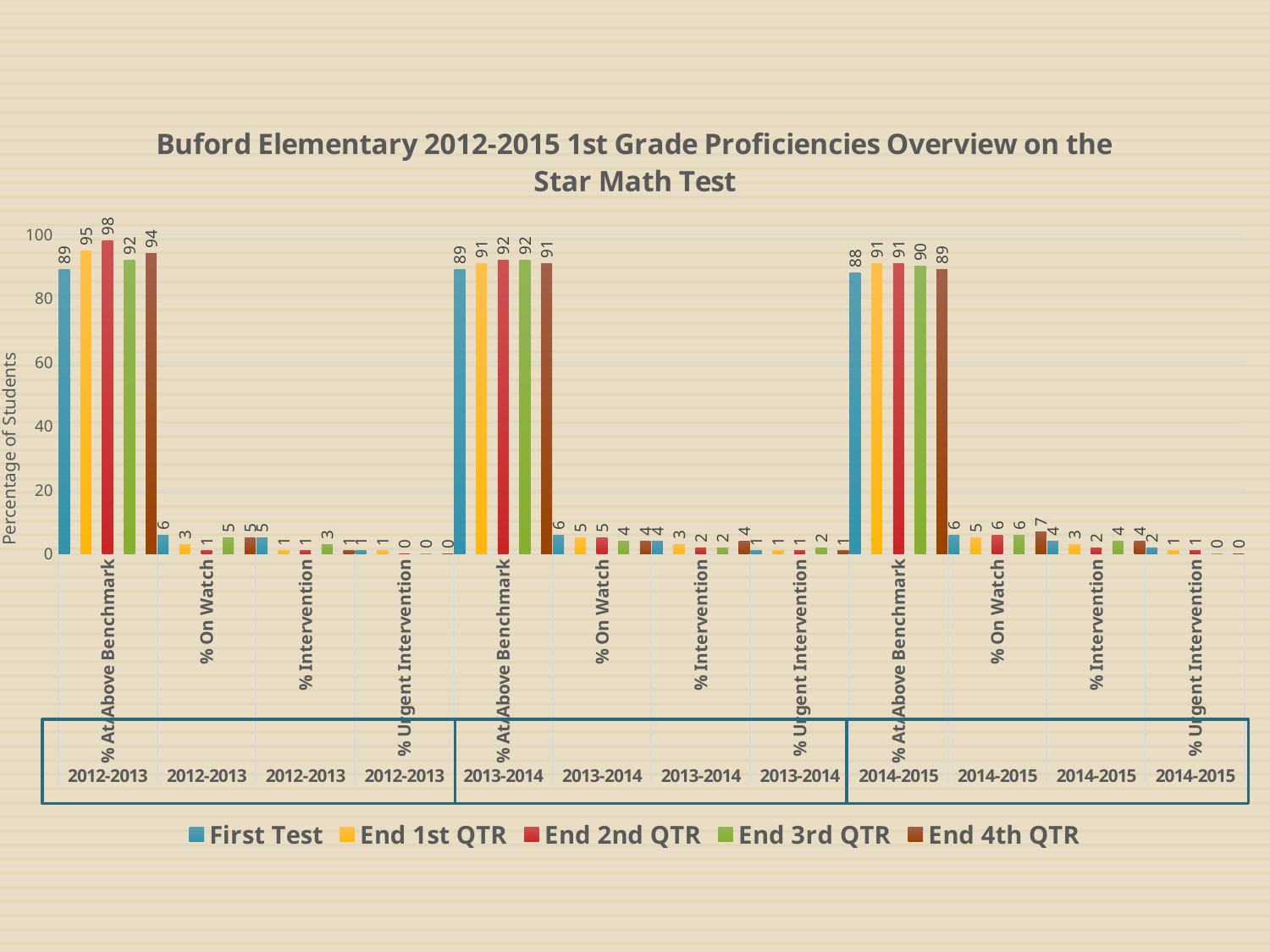
How many series does the legend list? 5 What is the First Test value for % At/Above Benchmark in 2014-2015? 88 Is the End 4th QTR value for % At/Above Benchmark in 2014-2015 greater or less than 80? greater How many categories are shown on the x axis? 12 Which is larger: the End 1st QTR value for % At/Above Benchmark in 2012-2013 or the End 1st QTR value for % At/Above Benchmark in 2013-2014? 2012-2013 (95) What is the End 2nd QTR value for % At/Above Benchmark in 2012-2013? 98 Which series has the highest value for % At/Above Benchmark in 2012-2013? End 2nd QTR What is the End 3rd QTR value for % Urgent Intervention in 2013-2014? 2 What is the difference between the End 2nd QTR and First Test values for % At/Above Benchmark in 2012-2013? 9 What is the label of the y axis? Percentage of Students What is the End 4th QTR value for % On Watch in 2014-2015? 7 What kind of chart is shown on the slide? Bar chart